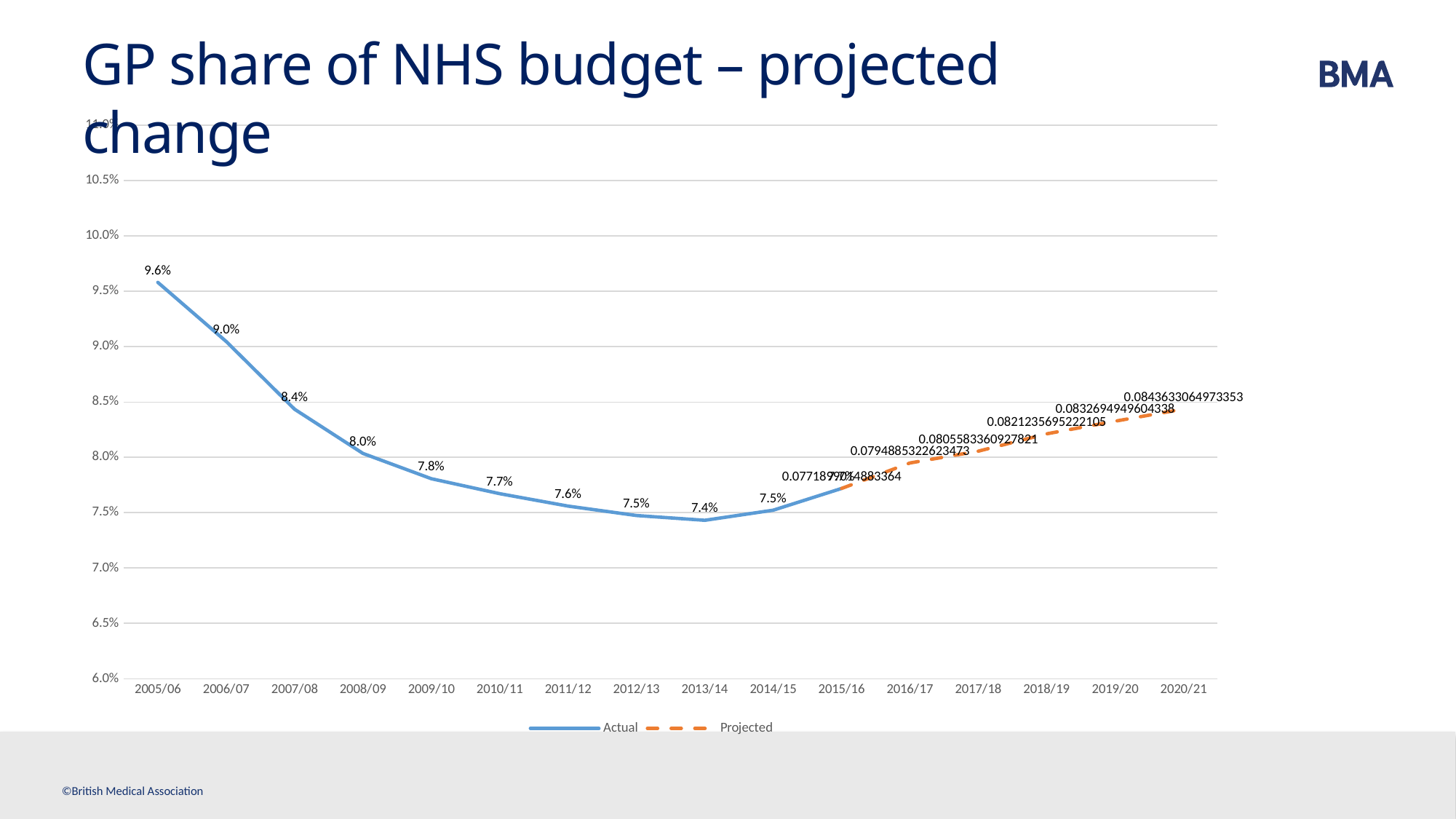
Is the projected value for 2019/20 greater or less than 8.0%? greater Which year has the highest value on the Actual line? 2005/06 Which year has the lowest value on the Actual line? 2013/14 Does the Actual line rise or fall from 2005/06 to 2013/14? fall What is the difference between the values for 2005/06 and 2007/08? 1.2% What is the value for 2013/14 on the Actual line? 7.4% How many series does the legend list? 2 What is the GP share of NHS budget for 2005/06? 9.6% What type of chart is shown on the slide? line chart Which is larger, the value for 2006/07 or the value for 2009/10? 2006/07 What is the value for 2008/09? 8.0% What is the projected value labelled for 2020/21? 0.0843633064973353